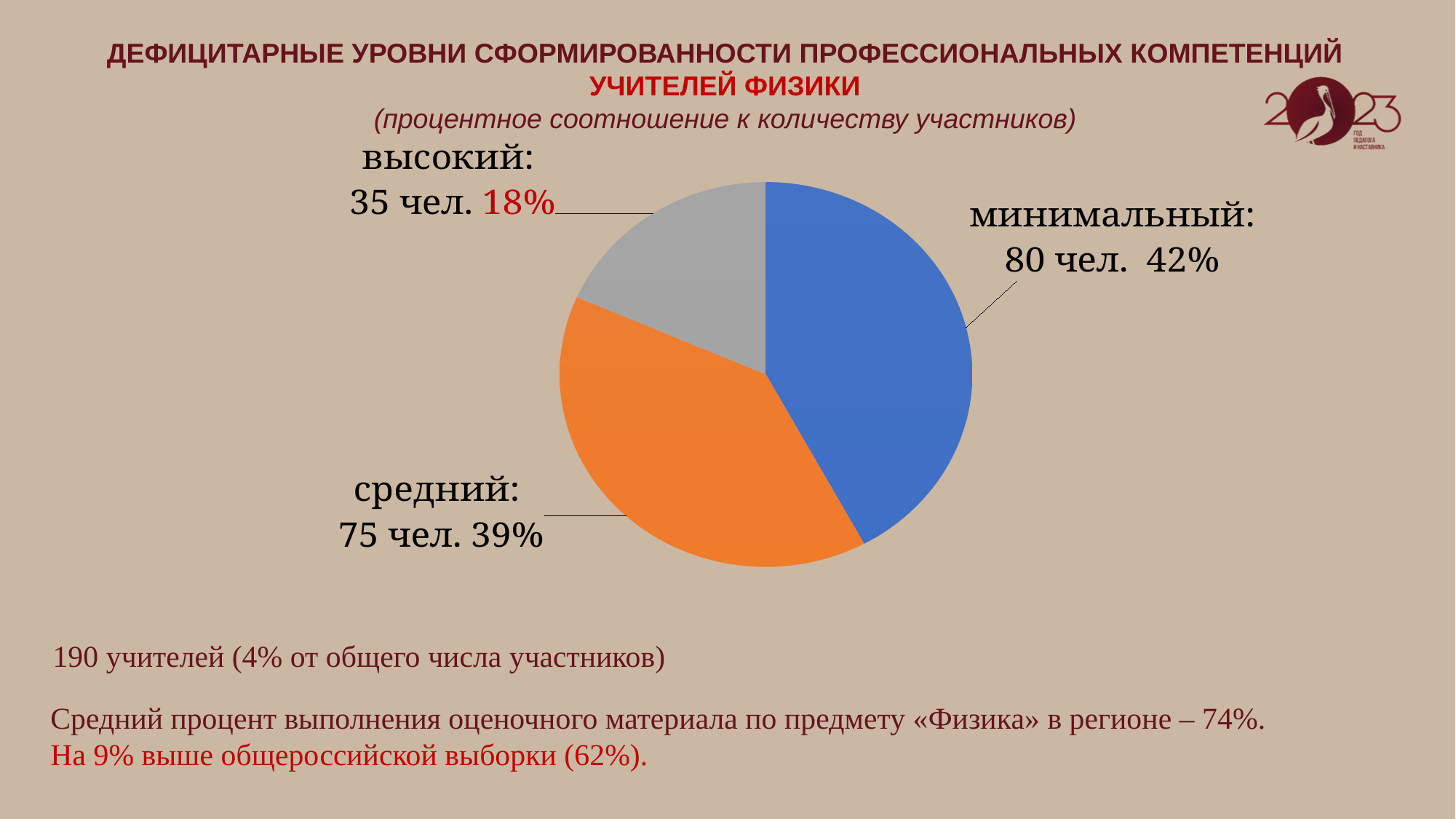
What percentage is shown for the "высокий" level? 18% Which level has the largest share of the pie? минимальный Which level has the smallest share of the pie? высокий How many people (чел.) are in the "минимальный" level? 80 чел. What is the difference in the number of people between the "минимальный" and "высокий" levels? 45 чел. How many slices does the pie chart have? 3 What percentage is shown for the "минимальный" level? 42% How many people (чел.) are in the "средний" level? 75 чел. What kind of chart is shown on the slide? pie chart What colour is the slice for the "средний" level? orange What is the total number of people across all three levels of the pie chart? 190 Which has more people: the "средний" level or the "высокий" level? средний